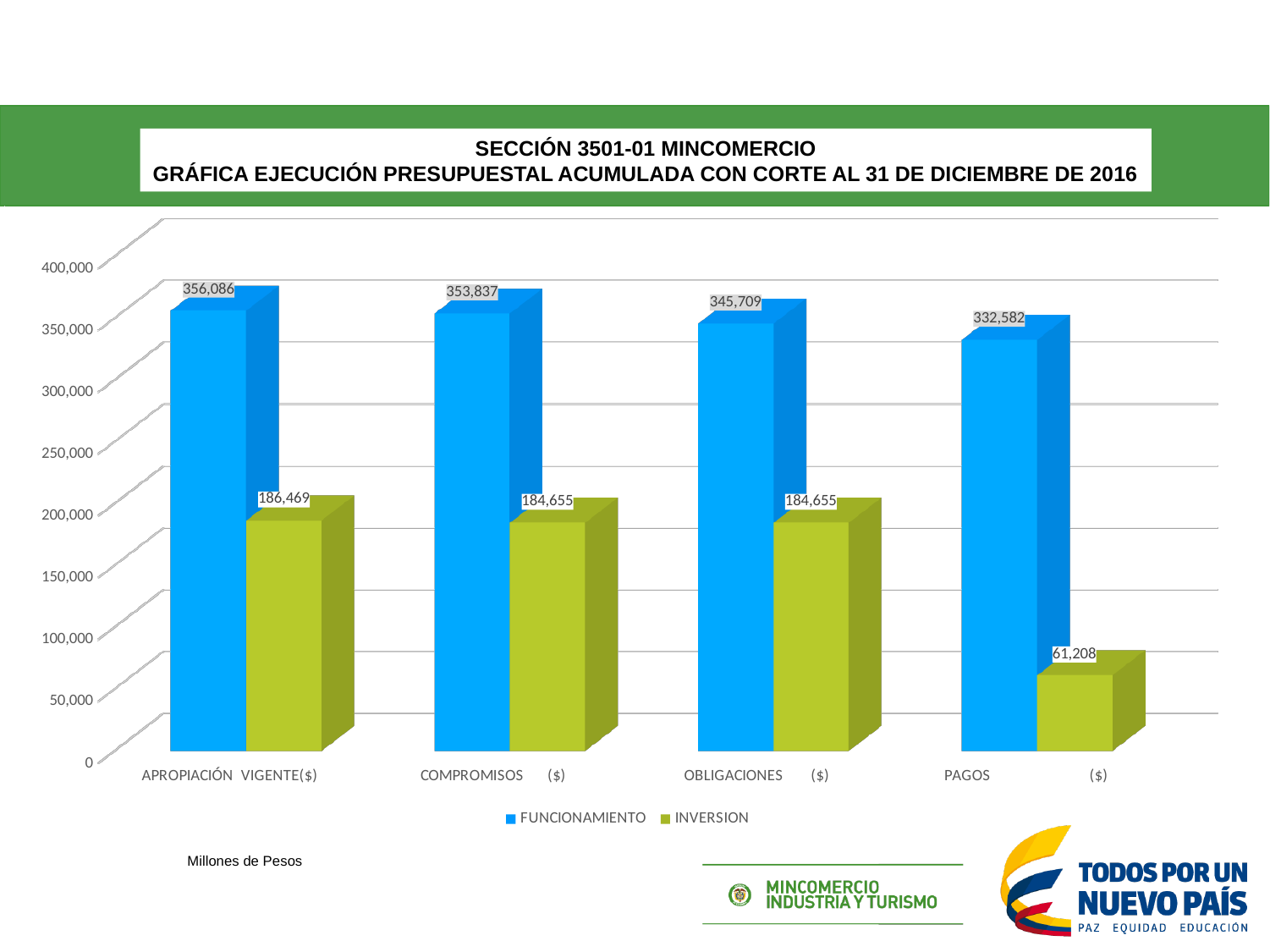
What is the difference between the FUNCIONAMIENTO and INVERSION values for PAGOS ($)? 271,374 What is the INVERSION value for COMPROMISOS ($)? 184,655 What is the difference between the FUNCIONAMIENTO values for APROPIACIÓN VIGENTE($) and COMPROMISOS ($)? 2,249 What is the INVERSION value for PAGOS ($)? 61,208 What kind of chart is shown on the slide? Bar chart How many categories are shown on the x axis? 4 Which category has the lowest FUNCIONAMIENTO value? PAGOS ($) What is the FUNCIONAMIENTO value for OBLIGACIONES ($)? 345,709 Which category has the highest INVERSION value? APROPIACIÓN VIGENTE($) Which is larger: the INVERSION value for APROPIACIÓN VIGENTE($) or the INVERSION value for PAGOS ($)? APROPIACIÓN VIGENTE($) What is the FUNCIONAMIENTO value for APROPIACIÓN VIGENTE($)? 356,086 How many series does the legend list? 2